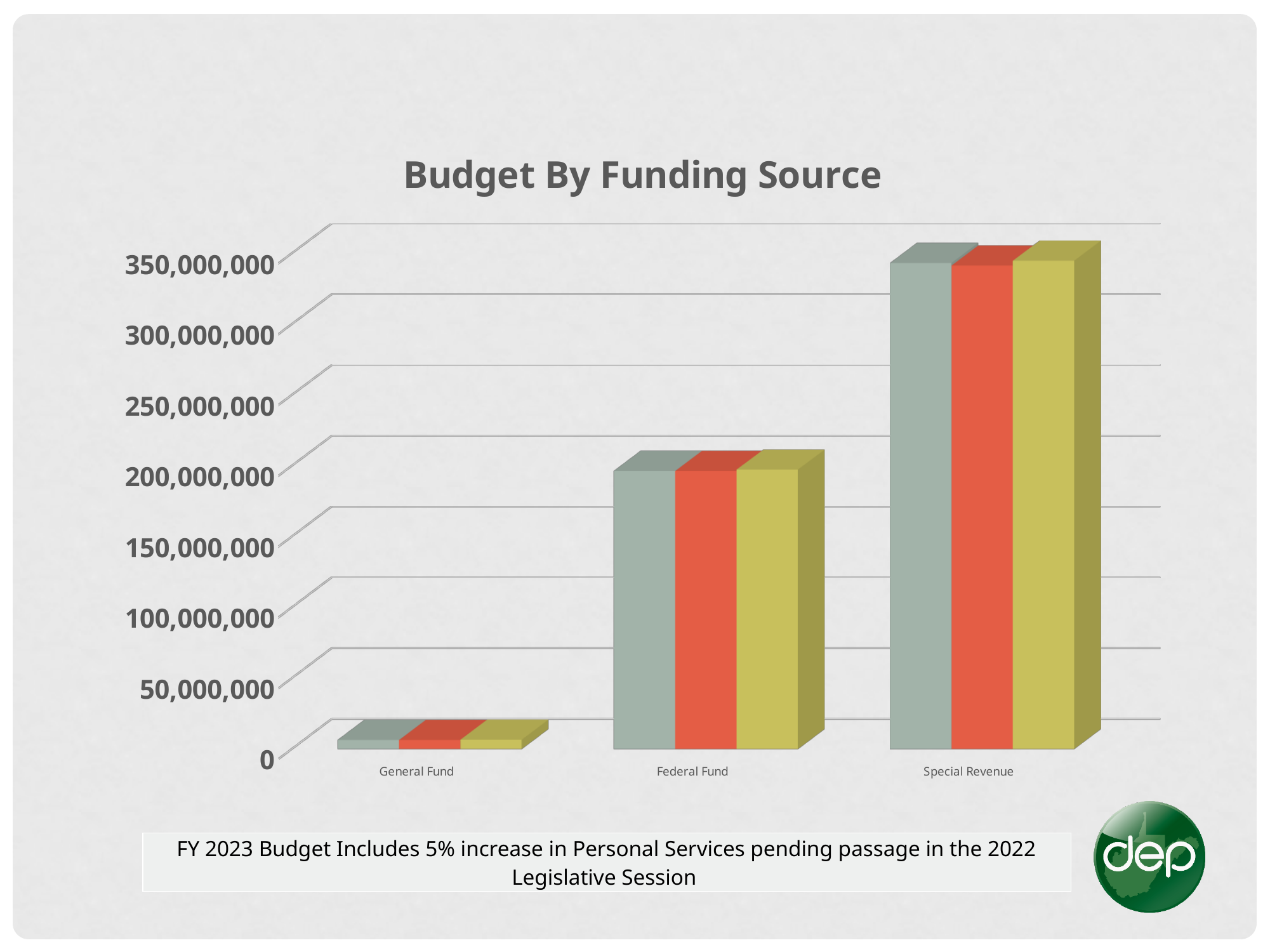
Is the value for General Fund greater or less than 50,000,000? less Is the value for Federal Fund greater or less than 150,000,000? greater Do the values rise or fall moving from General Fund to Special Revenue along the x axis? rise Which funding source has the lowest budget? General Fund Which is larger, the budget for Federal Fund or for General Fund? Federal Fund Which is larger, the budget for Special Revenue or for Federal Fund? Special Revenue What is the title of the chart? Budget By Funding Source How many funding source categories are shown on the x axis? 3 Is the value for Special Revenue greater or less than 300,000,000? greater What kind of chart is shown on the slide? Bar chart Which funding source has the highest budget? Special Revenue